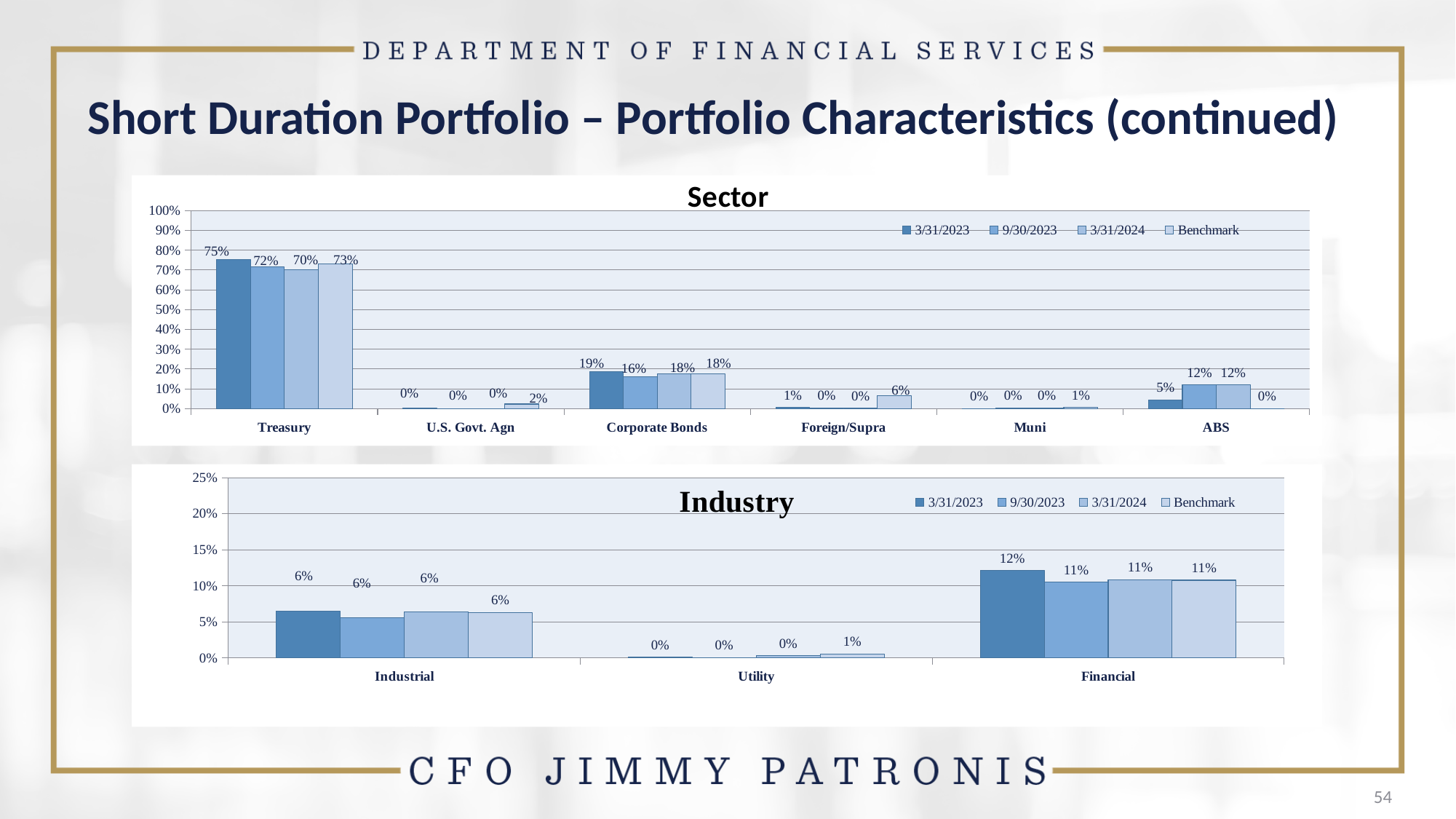
In the Industry chart, what is the Benchmark value for Utility? 1% In the Industry chart, is the Financial value for 3/31/2023 larger or smaller than the Industrial value for 3/31/2023? larger What kind of chart is the Industry chart? bar chart In the Sector chart, how many series does the legend list? 4 In the Industry chart, which category has the lowest value for 3/31/2023? Utility In the Sector chart, what is the difference between the Treasury values for 3/31/2023 and 3/31/2024? 5% In the Sector chart, what is the Benchmark value for Foreign/Supra? 6% In the Sector chart, what is the ABS value for 3/31/2024? 12% In the Sector chart, what is the Treasury value for 3/31/2023? 75% In the Sector chart, how many categories are shown on the x axis? 6 In the Industry chart, what is the Financial value for 3/31/2023? 12% In the Sector chart, which category has the highest value for 3/31/2024? Treasury